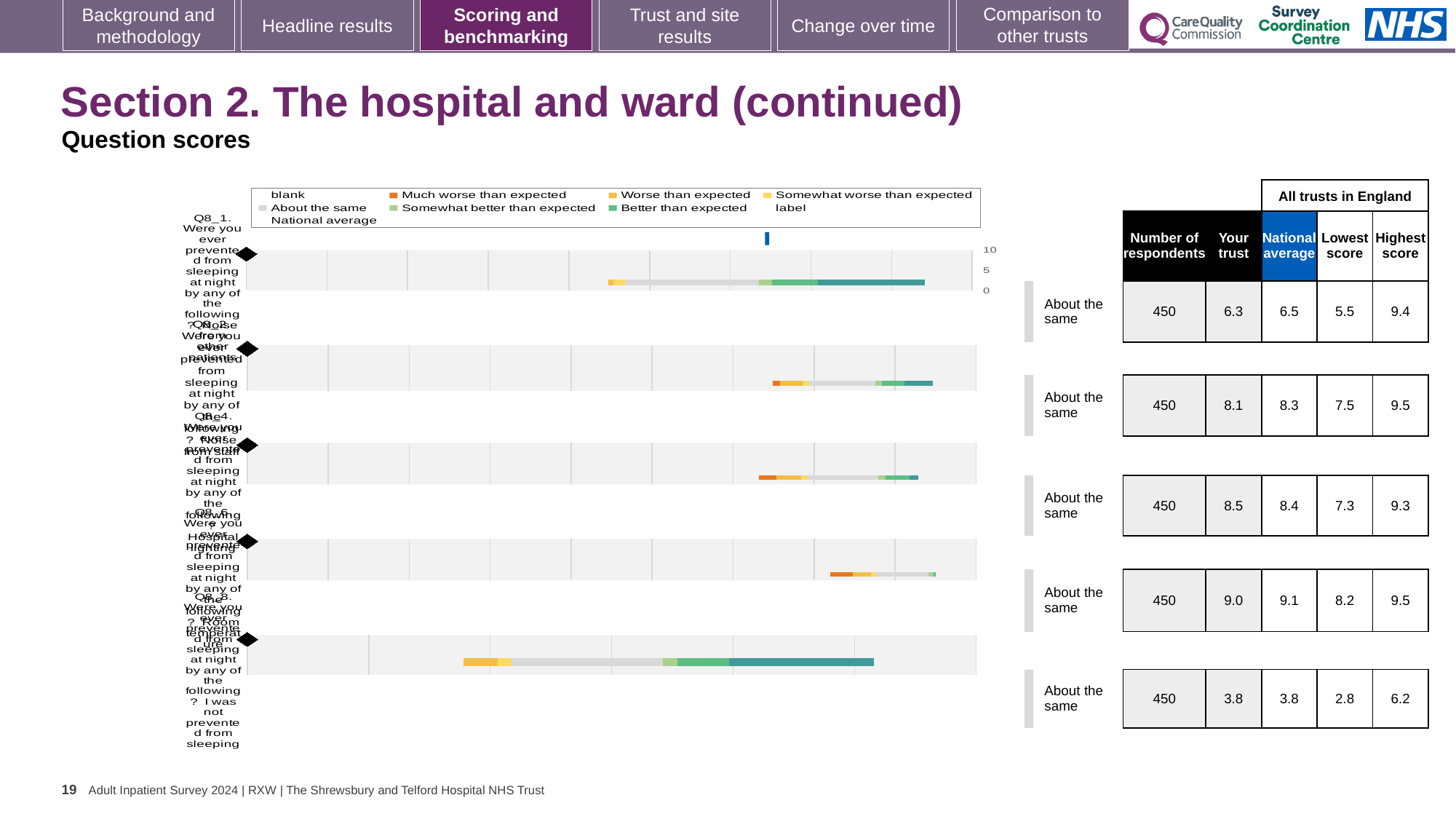
In the table beside the chart, what is the national average for the last row (Q8_8)? 3.8 In the table beside the chart, what is the 'Your trust' score for the first row (Q8_1)? 6.3 What is the highest value shown on the chart's axis scale? 10 How many question rows (bars) are plotted in the chart? 5 In the table beside the chart, which row has the highest 'Your trust' score? Q8_6 (9.0) What benchmark label is shown next to each of the five question rows in the chart? About the same In the table beside the chart, is the 'Your trust' score for the third row (Q8_4) larger or smaller than its national average? larger What kind of chart is shown on the slide? bar chart In the table beside the chart, what is the difference between the highest score and lowest score for the first row (Q8_1)? 3.9 In the table beside the chart, how many respondents are listed for each question row? 450 In the table beside the chart, which row has the lowest 'Your trust' score? Q8_8 (3.8) What colour does the legend use for 'Much worse than expected'? orange